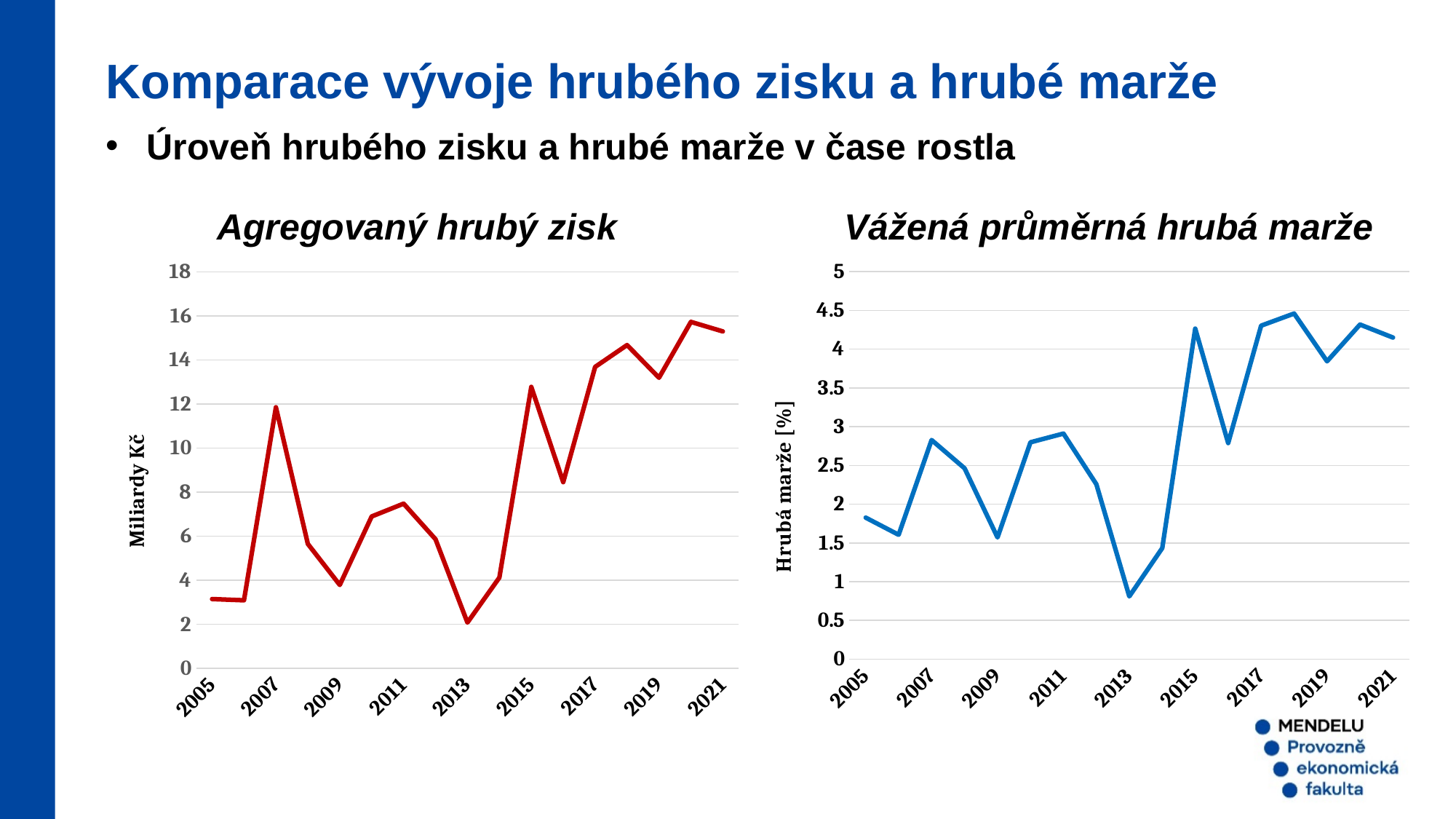
In the "Vážená průměrná hrubá marže" chart, is the value for 2015 greater or less than 4? greater In the "Vážená průměrná hrubá marže" chart, which year has the larger value, 2016 or 2017? 2017 What kind of chart is the "Agregovaný hrubý zisk" chart on the left? line chart What is the y-axis label of the "Agregovaný hrubý zisk" chart? Miliardy Kč Overall, do the values in the "Agregovaný hrubý zisk" chart rise or fall from 2005 to 2021? rise In the "Agregovaný hrubý zisk" chart, is the value for 2007 greater or less than 10? greater In the "Vážená průměrná hrubá marže" chart, which year has the lowest value? 2013 In the "Agregovaný hrubý zisk" chart, is the value for 2013 greater or less than 4? less What kind of chart is the "Vážená průměrná hrubá marže" chart on the right? line chart In the "Agregovaný hrubý zisk" chart, which year has the lowest value? 2013 In the "Agregovaný hrubý zisk" chart, which year has the larger value, 2007 or 2009? 2007